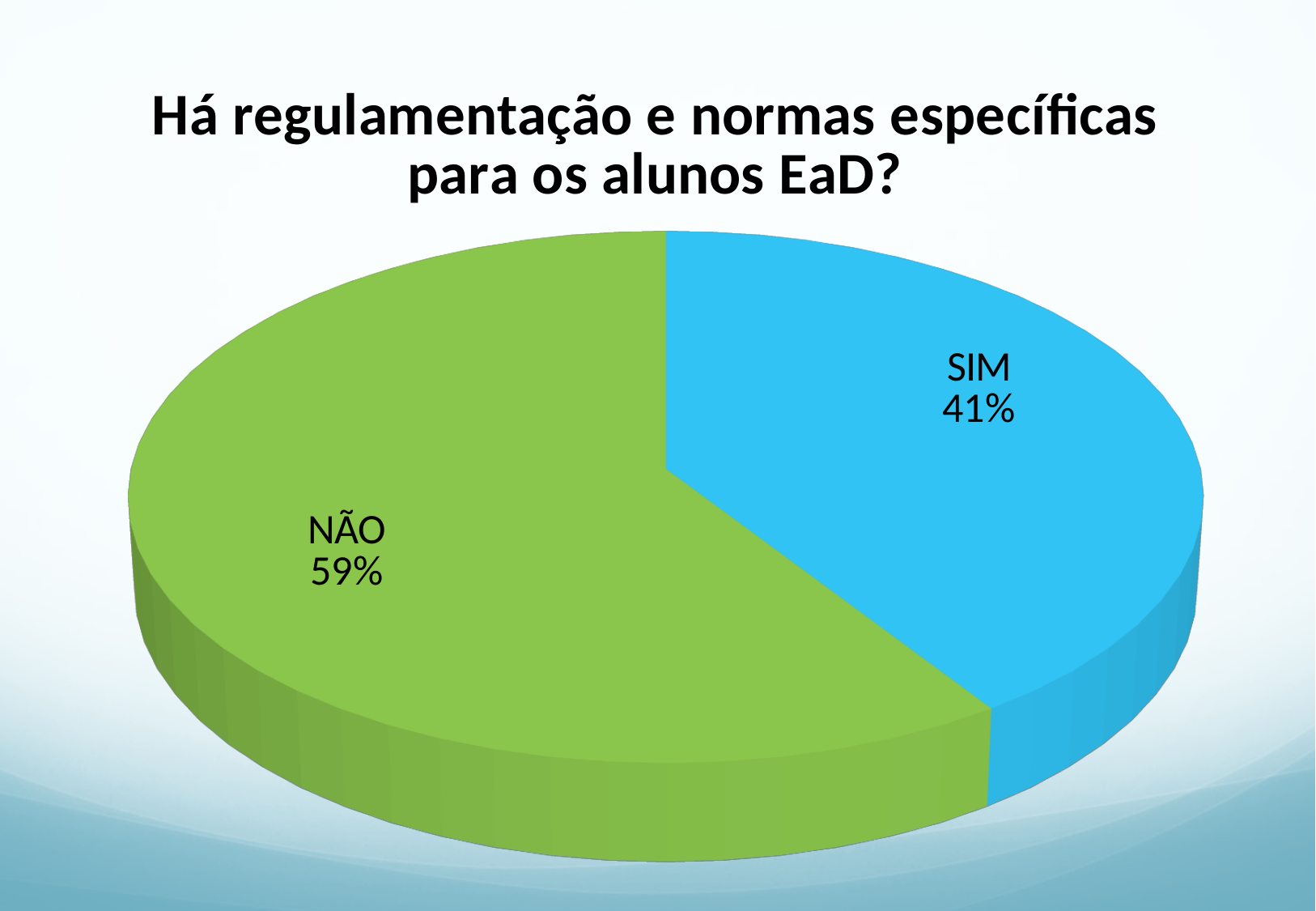
What share of the pie does the SIM slice represent? 41% What colour is the NÃO slice? Green What kind of chart is shown on the slide? Pie chart What percentage is shown for the SIM slice? 41% Which is larger, the SIM slice or the NÃO slice? NÃO What is the difference in percentage points between the NÃO and SIM slices? 18 How many slices does the pie chart have? 2 Which slice is the largest? NÃO What percentage is shown for the NÃO slice? 59% What is the title of the chart? Há regulamentação e normas específicas para os alunos EaD? Which slice is the smallest? SIM